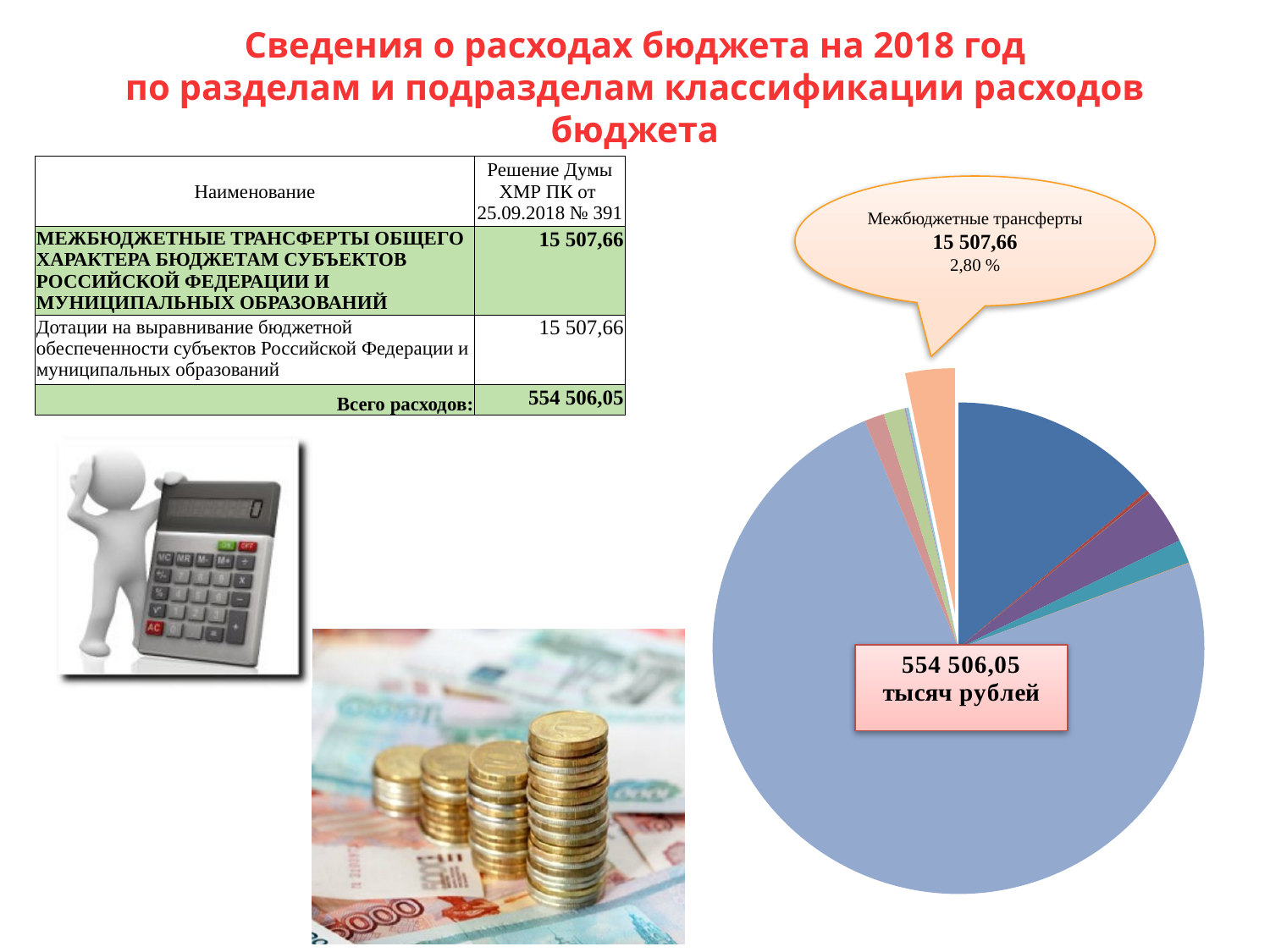
Is the slice for Межбюджетные трансферты one of the smaller or one of the larger slices of the pie chart? smaller Which slice of the pie chart is pulled out (exploded) from the rest of the pie? Межбюджетные трансферты In the pie chart, what share of the total do Межбюджетные трансферты represent according to the callout? 2,80 % What total amount is shown in the box on the pie chart? 554 506,05 тысяч рублей What kind of chart is shown on the right side of the slide? pie chart In the pie chart, what value is given in the callout for Межбюджетные трансферты? 15 507,66